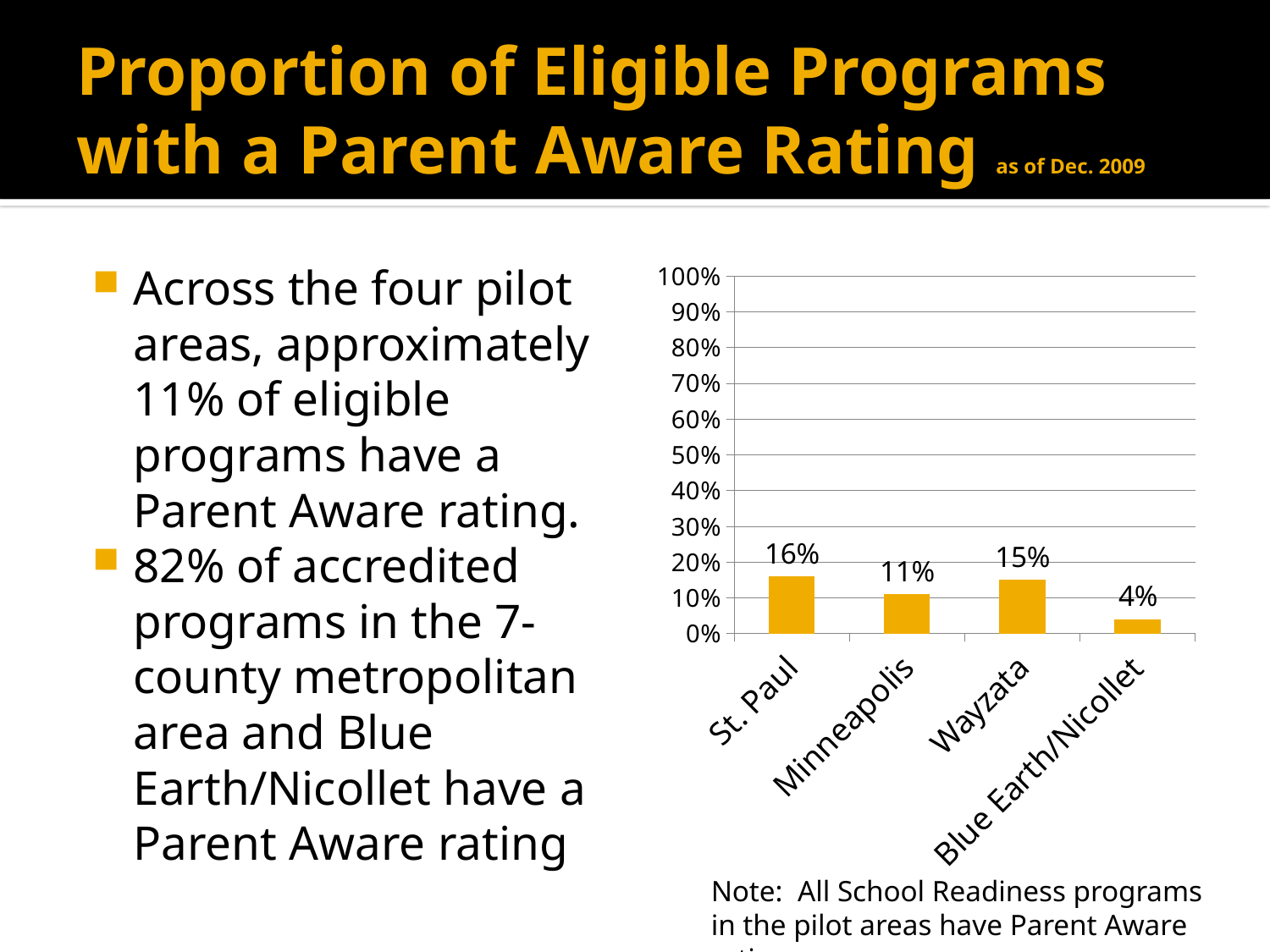
What is the value for Blue Earth/Nicollet? 4% Which is larger, the value for Minneapolis or the value for Wayzata? Wayzata What kind of chart is shown on the slide? Bar chart What is the value for St. Paul? 16% Which pilot area has the highest proportion of eligible programs with a Parent Aware rating? St. Paul What is the maximum value shown on the chart's vertical axis? 100% What is the difference between the values for St. Paul and Blue Earth/Nicollet? 12% What is the difference between the values for Wayzata and Minneapolis? 4% Which pilot area has the lowest proportion of eligible programs with a Parent Aware rating? Blue Earth/Nicollet What is the value for Wayzata? 15% How many pilot areas are shown on the chart? 4 What is the value for Minneapolis? 11%